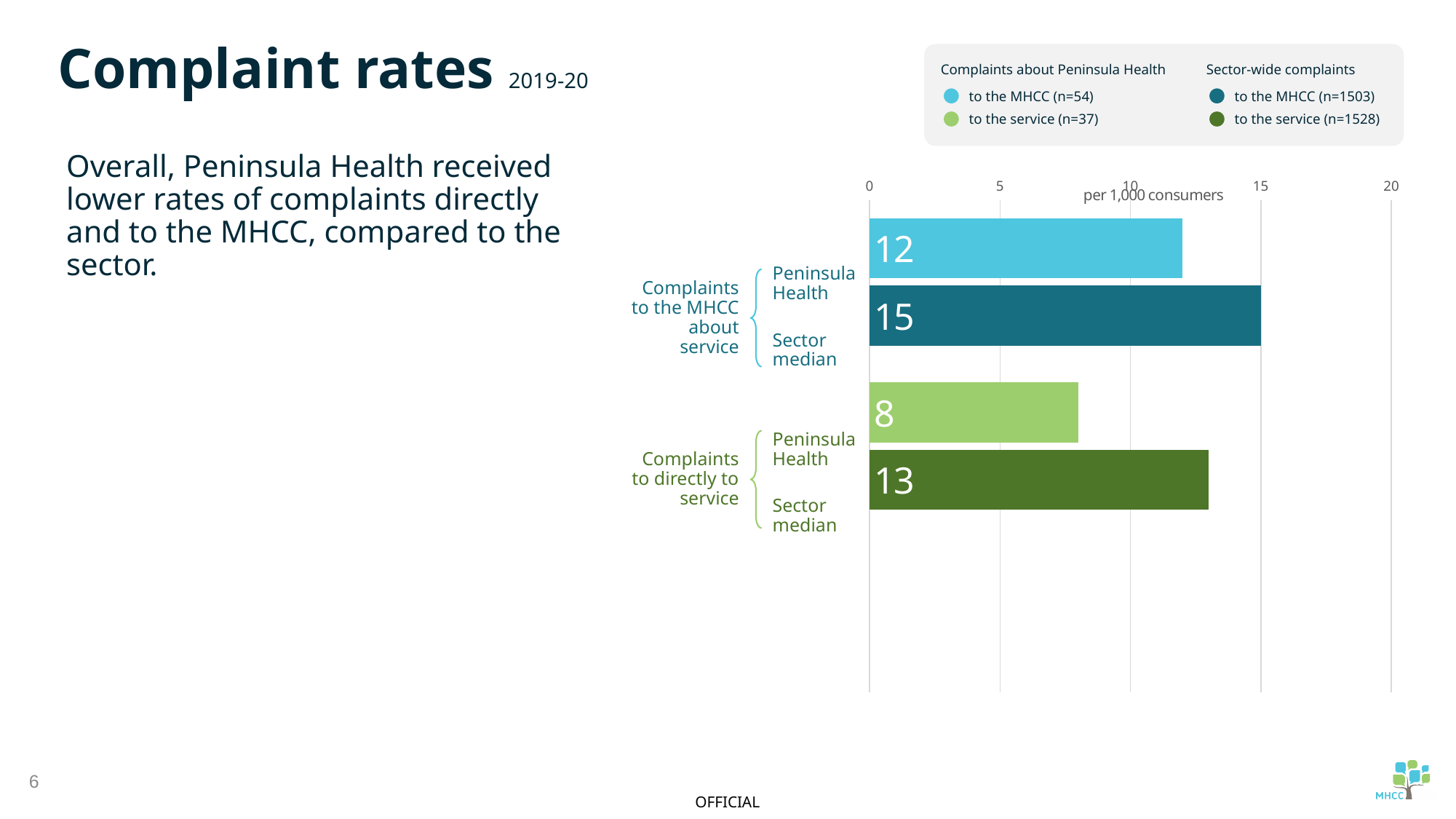
What is the difference between the sector median and Peninsula Health for complaints directly to service? 5 What is the rate of complaints made directly to service for Peninsula Health, per 1,000 consumers? 8 What is the sector median rate of complaints made directly to service, per 1,000 consumers? 13 What is the difference between the sector median and Peninsula Health for complaints to the MHCC about service? 3 Which bar shows the lowest complaint rate? Peninsula Health, complaints directly to service For complaints directly to service, which is larger: Peninsula Health or the sector median? Sector median What is the sector median rate of complaints to the MHCC about service, per 1,000 consumers? 15 According to the legend, how many complaints about Peninsula Health were made to the MHCC (n)? 54 What kind of chart is shown on the slide? Bar chart Which bar shows the highest complaint rate? Sector median, complaints to the MHCC about service How many bars are plotted on the chart? 4 What is the rate of complaints to the MHCC about service for Peninsula Health, per 1,000 consumers? 12